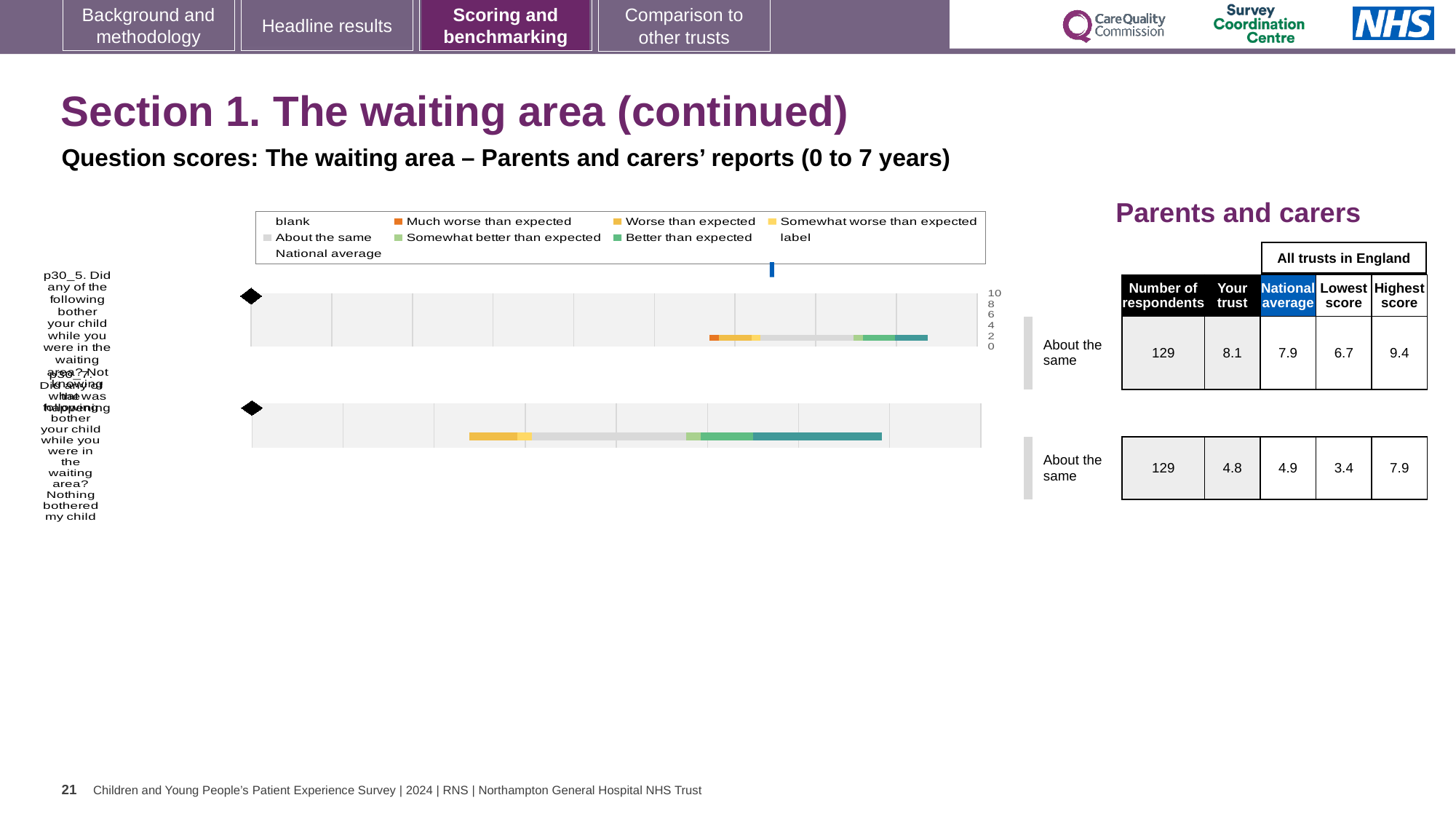
In the table beside the chart, what is the 'Your trust' score for the first question (p30_5)? 8.1 Which legend entry is shown in orange? Much worse than expected In the table beside the chart, how many respondents answered the first question (p30_5)? 129 How many bars (questions) are plotted in the chart? 2 What kind of chart is shown on the slide? bar chart In the table beside the chart, what is the 'Your trust' score for the second question (p30_7)? 4.8 In the table beside the chart, is the 'Your trust' score for the first question (p30_5) larger or smaller than for the second question (p30_7)? larger What is the highest value shown on the chart's axis? 10 In the table beside the chart, what is the national average for the first question (p30_5)? 7.9 In the table beside the chart, what is the highest score for the second question (p30_7)? 7.9 In the table beside the chart, what is the difference between the highest score and the lowest score for the first question (p30_5)? 2.7 How many entries does the chart legend list? 9